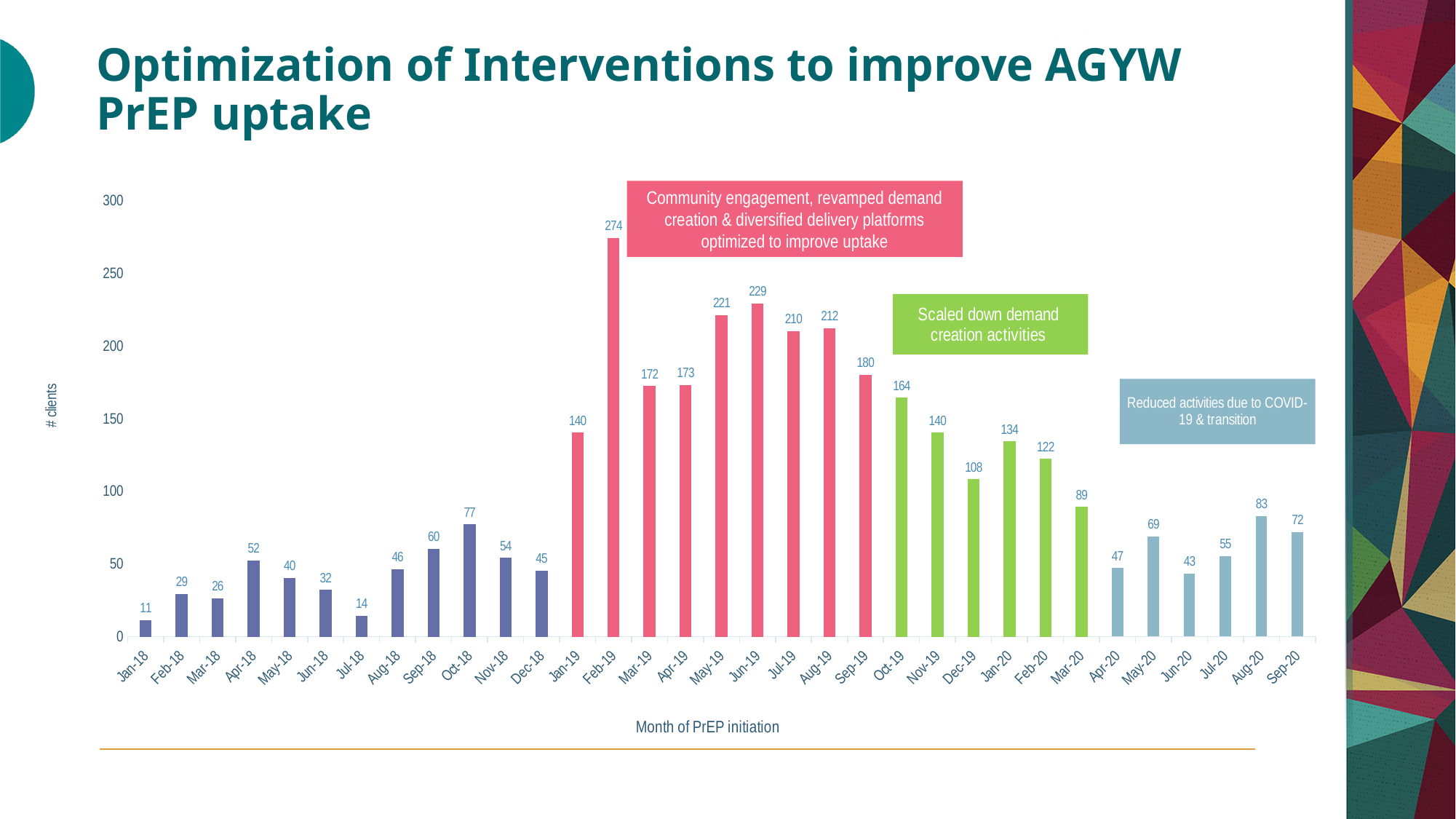
How many months are plotted on the x axis? 33 Which month has the lowest number of clients? Jan-18 Which month has the highest number of clients? Feb-19 What is the difference in clients between Jun-19 and May-19? 8 Is the value for Sep-19 greater or less than 150? greater What kind of chart is shown on the slide? Bar chart Which month has more clients, Aug-20 or Sep-20? Aug-20 What is the label of the x axis? Month of PrEP initiation What is the number of clients for Feb-19? 274 What is the difference in clients between Oct-19 and Mar-20? 75 What is the number of clients for Oct-18? 77 What is the number of clients for Dec-19? 108